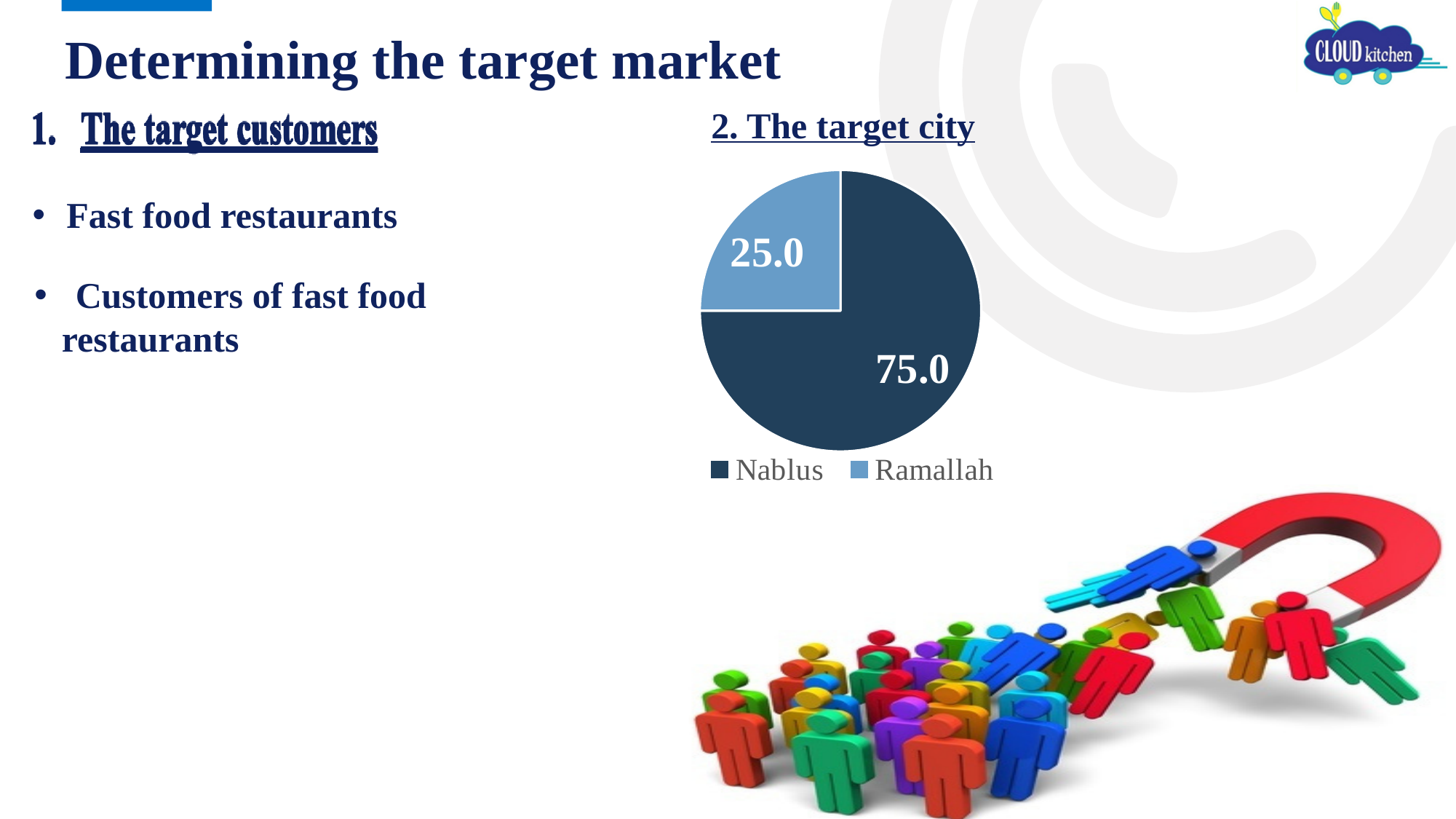
What is the difference between the values for Nablus and Ramallah in the pie chart? 50.0 What share of the pie chart does Nablus represent? 75.0 How many slices does the pie chart have? 2 What is the value shown for Ramallah in the pie chart? 25.0 Which city has the largest slice in the pie chart? Nablus What share of the pie chart does Ramallah represent? 25.0 Which city is shown in the lighter blue colour in the pie chart? Ramallah What is the value shown for Nablus in the pie chart? 75.0 Which is larger in the pie chart, Nablus or Ramallah? Nablus What kind of chart is shown under "2. The target city"? pie chart How many entries does the legend of the pie chart list? 2 Which city has the smallest slice in the pie chart? Ramallah